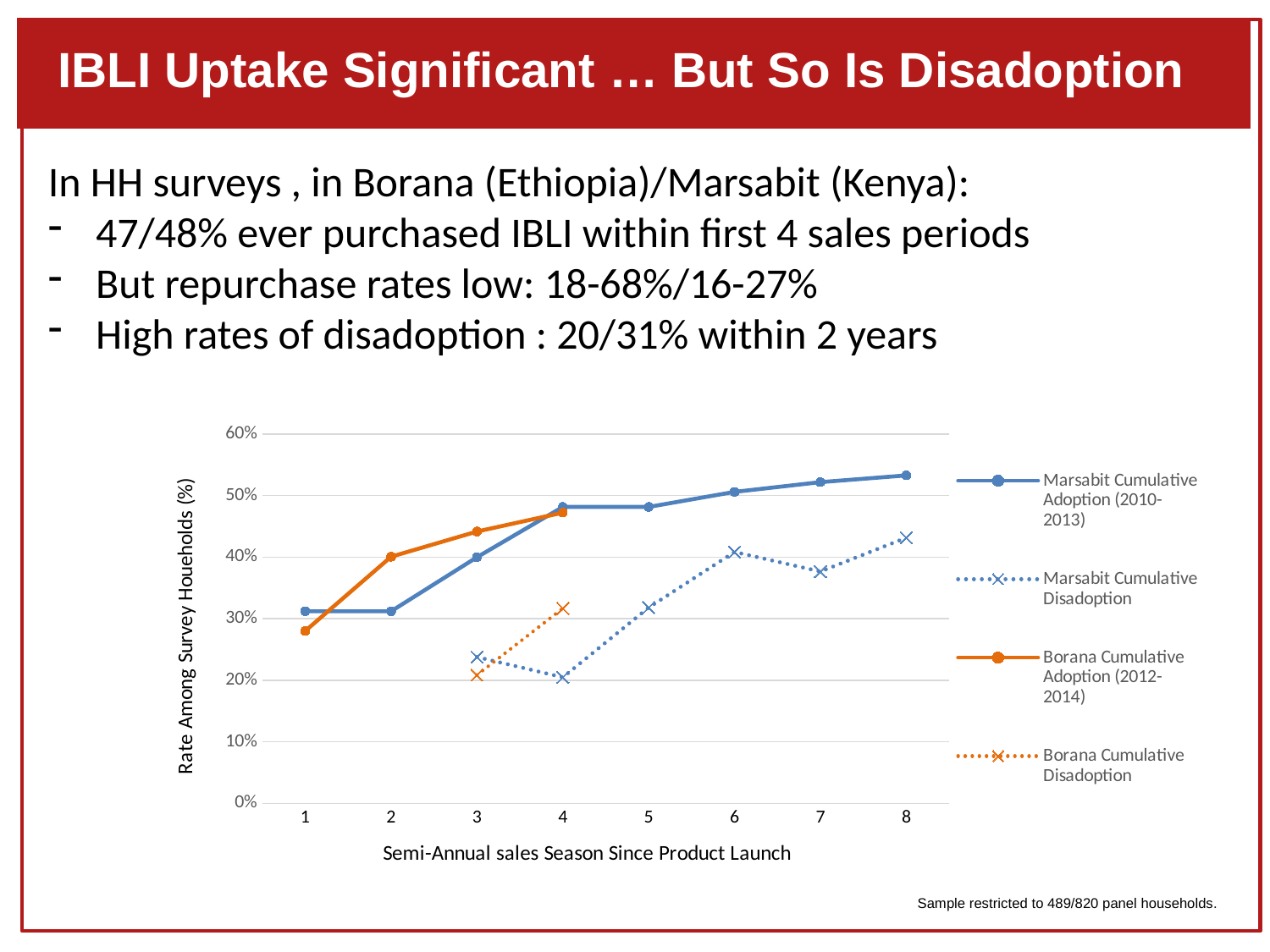
At season 2, which is higher: Borana Cumulative Adoption (2012-2014) or Marsabit Cumulative Adoption (2010-2013)? Borana Cumulative Adoption (2012-2014) Is the value for Marsabit Cumulative Disadoption at season 8 greater or less than 40%? greater What is the title of the x axis? Semi-Annual sales Season Since Product Launch Does Marsabit Cumulative Adoption (2010-2013) rise or fall from season 1 to season 8? Rise What is the title of the y axis? Rate Among Survey Households (%) Is the value for Marsabit Cumulative Adoption (2010-2013) at season 8 greater or less than 50%? greater In which season does Marsabit Cumulative Adoption (2010-2013) reach its highest value? 8 Is the value for Borana Cumulative Adoption (2012-2014) at season 1 greater or less than 40%? less What kind of chart is shown on the slide? Line chart How many series does the chart legend list? 4 How many semi-annual sales seasons are shown on the x axis? 8